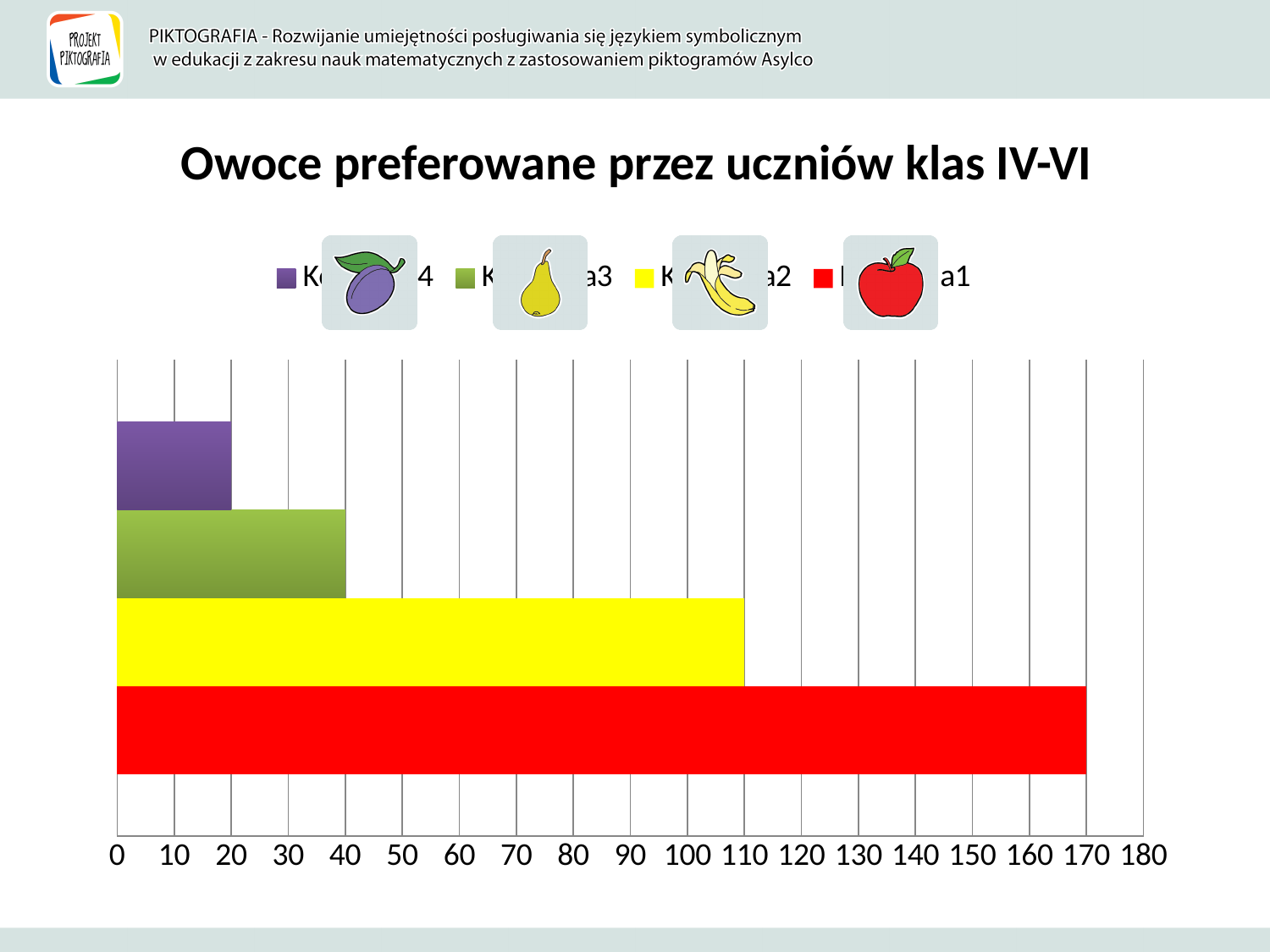
What value does the yellow bar reach? 110 What value does the red bar reach? 170 Which is larger, the green bar or the purple bar? the green bar How many series does the legend list? 4 What is the difference between the red bar and the yellow bar? 60 Which bar is the shortest? the purple bar What value does the purple bar reach? 20 Is the value of the yellow bar greater or less than 100? greater What value does the green bar reach? 40 Which bar is the longest? the red bar What is the title of the chart? Owoce preferowane przez uczniów klas IV-VI What kind of chart is shown on the slide? bar chart